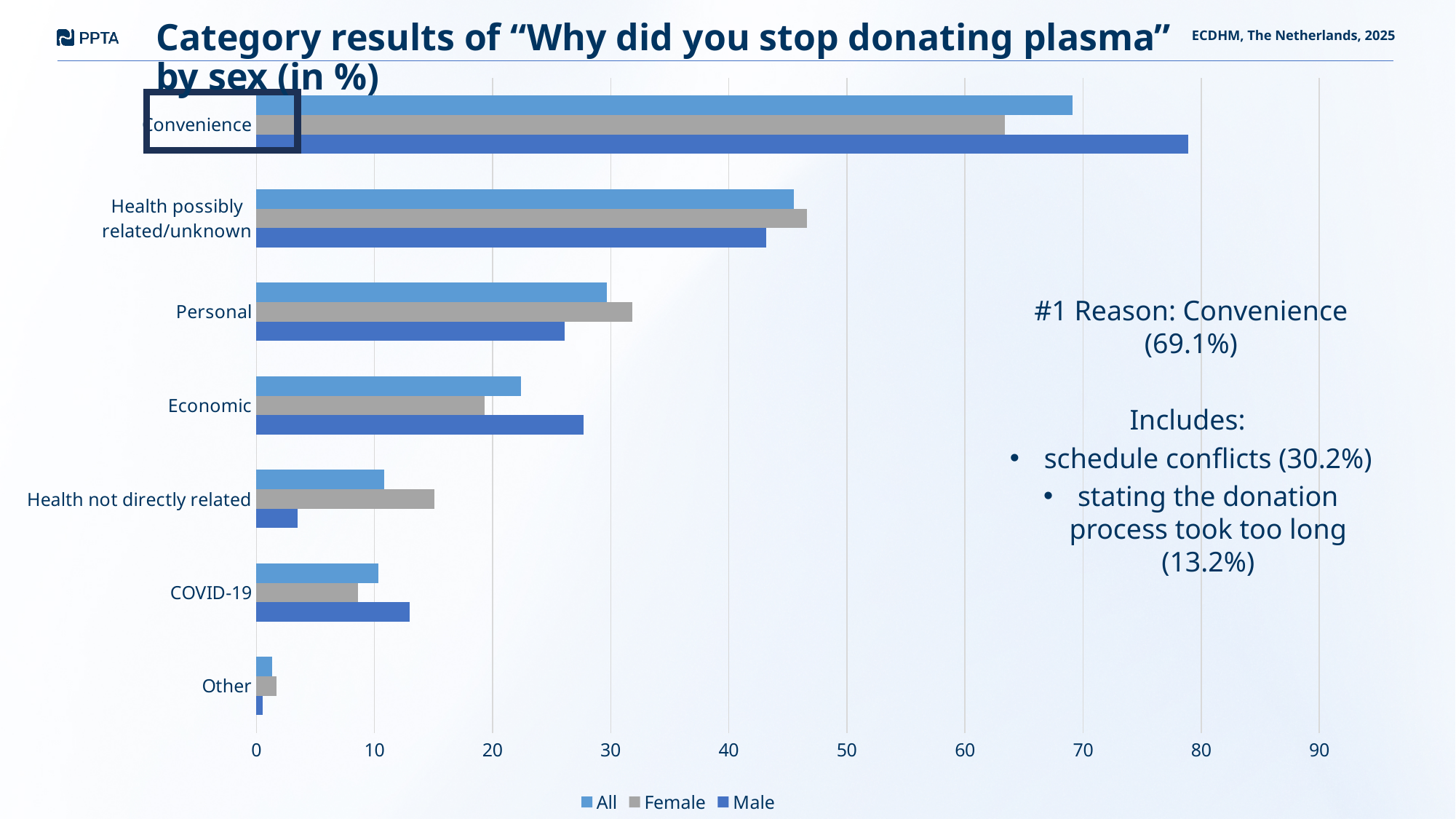
How many reason categories are plotted on the chart? 7 Which category has the highest value in the All series? Convenience What kind of chart is shown on the slide? bar chart For Personal, which is larger: the Female value or the Male value? Female Is the Male value for Health not directly related greater or less than 10? less Is the Male value for Convenience greater or less than 70? greater For Convenience, which is larger: the Male value or the Female value? Male Which category has the lowest value in the All series? Other How many series does the chart legend list? 3 Is the Male value for Economic greater or less than 20? greater What are the series names listed in the chart legend? All, Female, Male What is the value for Convenience in the All series? 69.1%